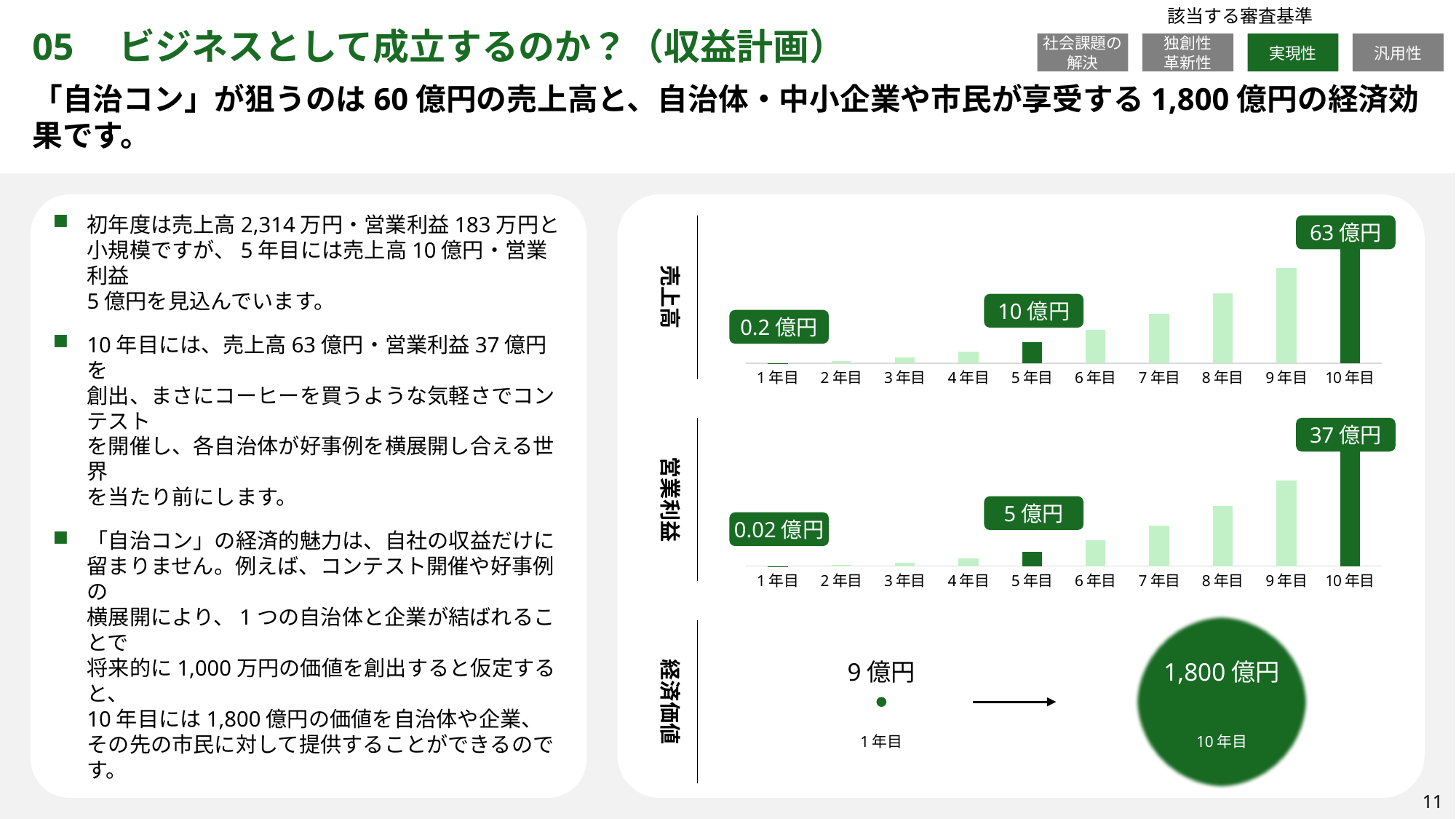
In the 営業利益 chart, what is the difference between the values for 10年目 and 5年目? 32 億円 In the 売上高 chart, what is the value for 10年目? 63 億円 How many year categories are shown on the x axis of the 売上高 chart? 10 In the 営業利益 chart, which year has the lowest value? 1年目 In the 売上高 chart, what is the value for 1年目? 0.2 億円 In the 営業利益 chart, what is the value for 10年目? 37 億円 In the 営業利益 chart, what is the value for 1年目? 0.02 億円 In the 売上高 chart, what is the difference between the values for 10年目 and 5年目? 53 億円 What kind of chart is the 営業利益 chart? bar chart In the 売上高 chart, what is the value for 5年目? 10 億円 In the 営業利益 chart, what is the value for 5年目? 5 億円 In the 売上高 chart, which year has the highest value? 10年目